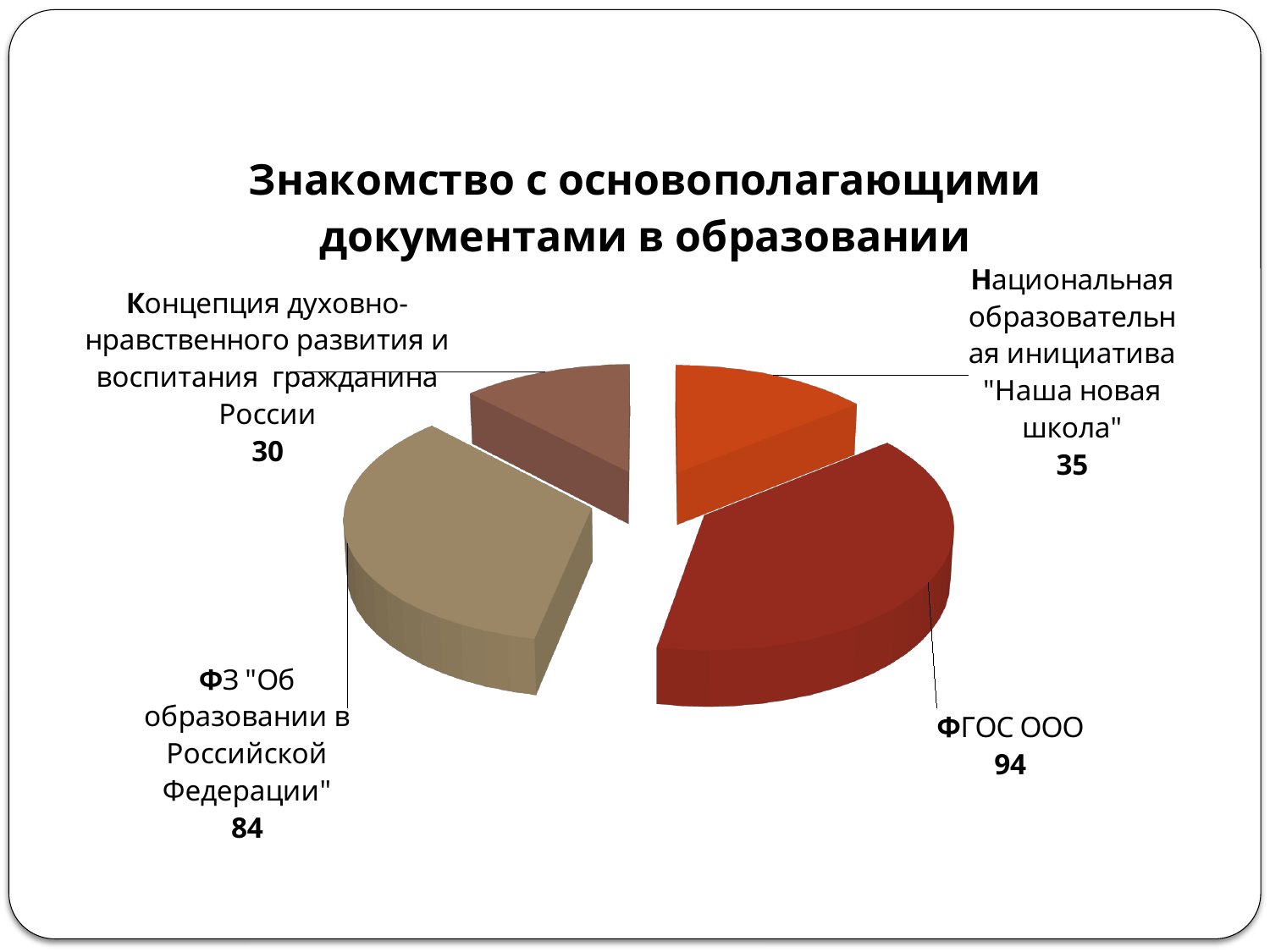
What is the total of all the values shown in the pie chart? 243 What is the value for ФГОС ООО? 94 What is the title of the chart? Знакомство с основополагающими документами в образовании What is the value for Национальная образовательная инициатива "Наша новая школа"? 35 What is the value for ФЗ "Об образовании в Российской Федерации"? 84 How many slices does the pie chart have? 4 Which category has the lowest value? Концепция духовно-нравственного развития и воспитания гражданина России What is the value for Концепция духовно-нравственного развития и воспитания гражданина России? 30 What type of chart is shown on the slide? pie chart Which is larger: the value for Национальная образовательная инициатива "Наша новая школа" or the value for Концепция духовно-нравственного развития и воспитания гражданина России? Национальная образовательная инициатива "Наша новая школа" Which category has the highest value? ФГОС ООО What is the difference between the values for ФГОС ООО and ФЗ "Об образовании в Российской Федерации"? 10